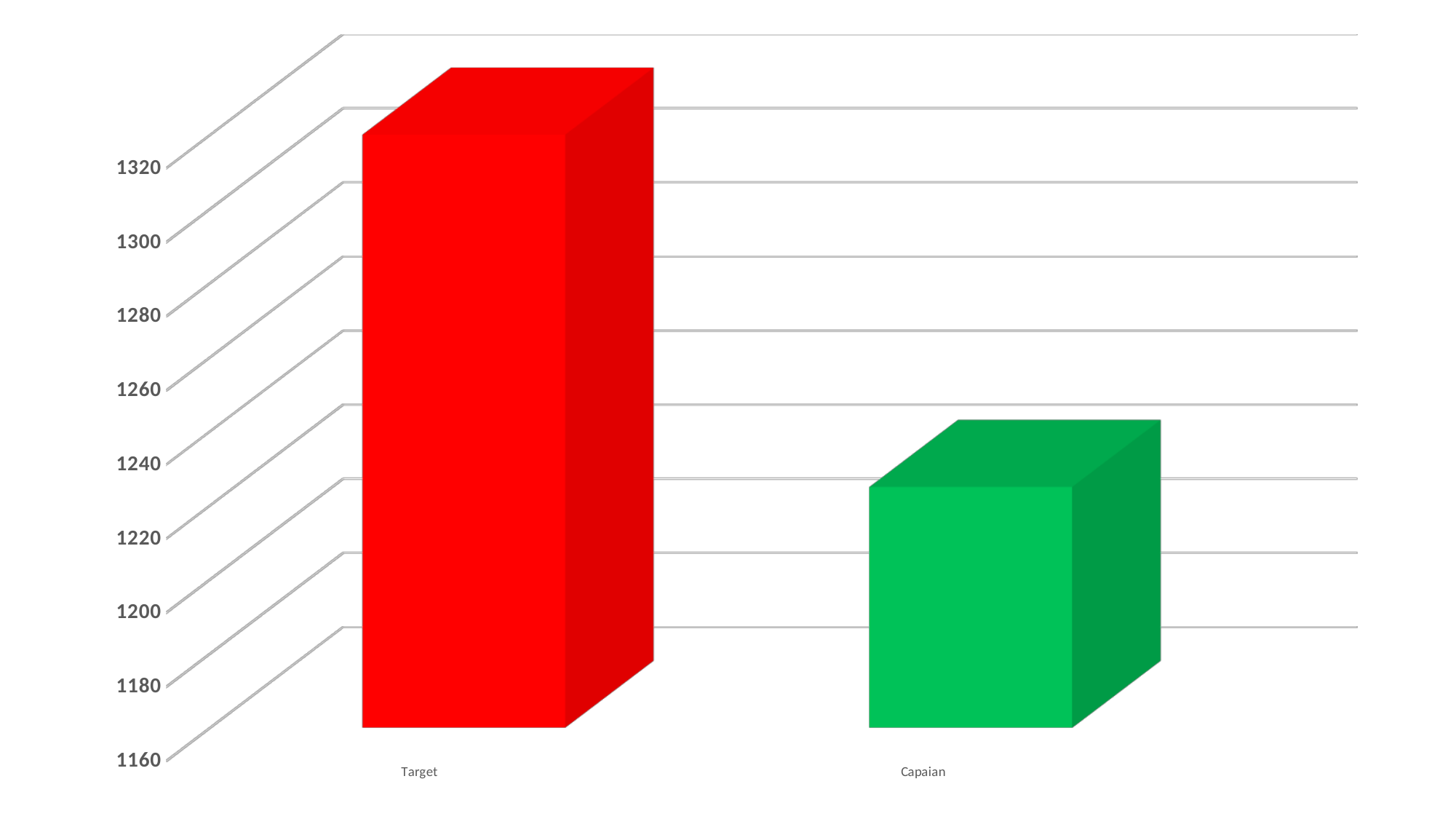
Is the value for Target greater or less than 1300? greater Is the value for Target greater or less than 1260? greater How many categories are plotted on the chart? 2 Which category has the highest value? Target Is the value for Capaian greater or less than 1260? less Which category has the lowest value? Capaian What kind of chart is shown on the slide? bar chart What colour is the bar for Capaian? green What colour is the bar for Target? red Which is larger, the value for Target or the value for Capaian? Target